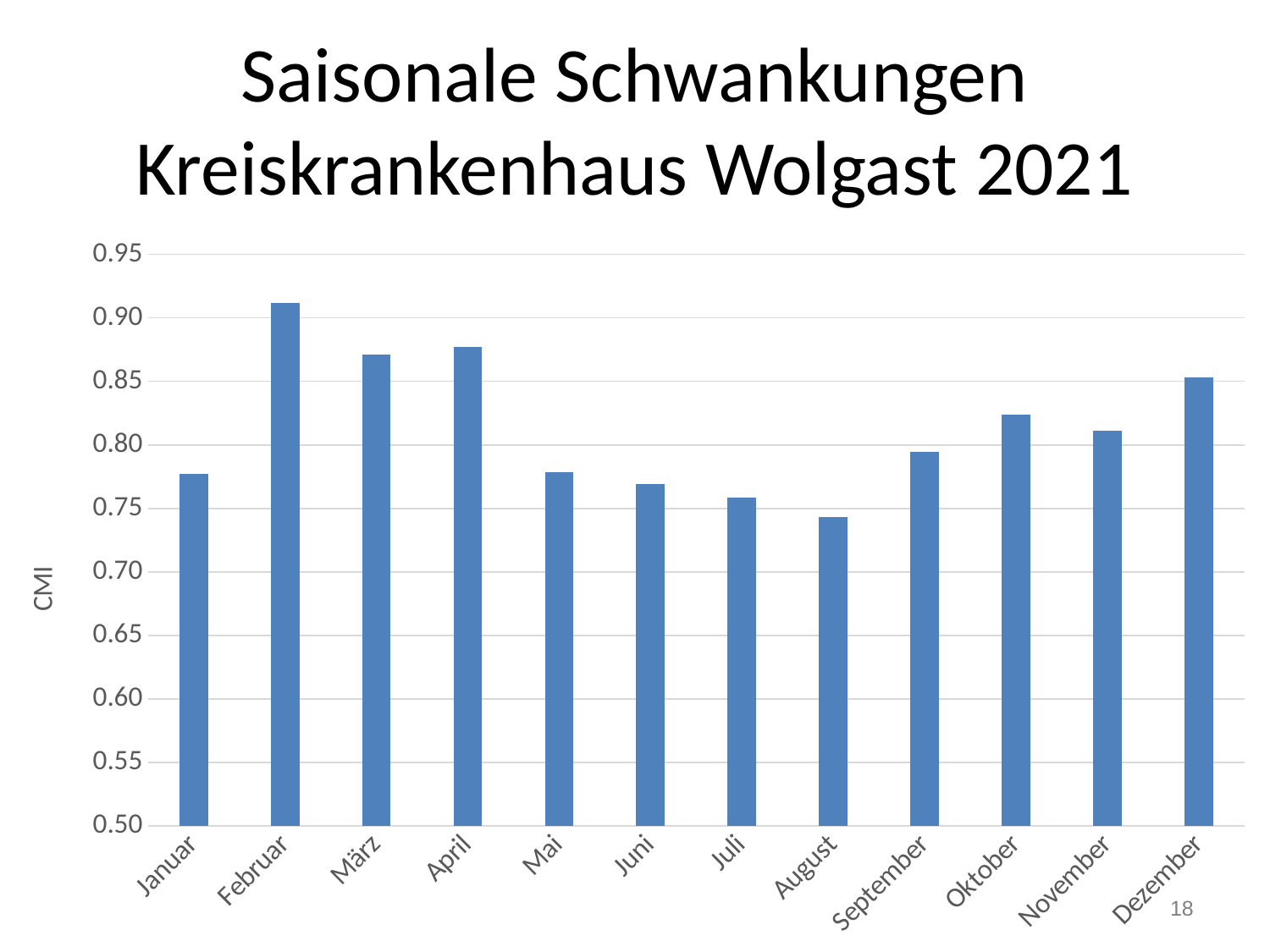
Is the value for Juni greater or less than 0.80? less What kind of chart is shown on the slide? bar chart How many months are plotted on the chart? 12 Which month has the highest CMI value? Februar Which is larger, the value for Februar or the value for Dezember? Februar What is the label on the vertical axis? CMI Is the value for Februar greater or less than 0.90? greater Which month has the lowest CMI value? August Which is larger, the value for Juni or the value for September? September Do the values rise or fall from Februar to August? fall Is the value for August greater or less than 0.75? less